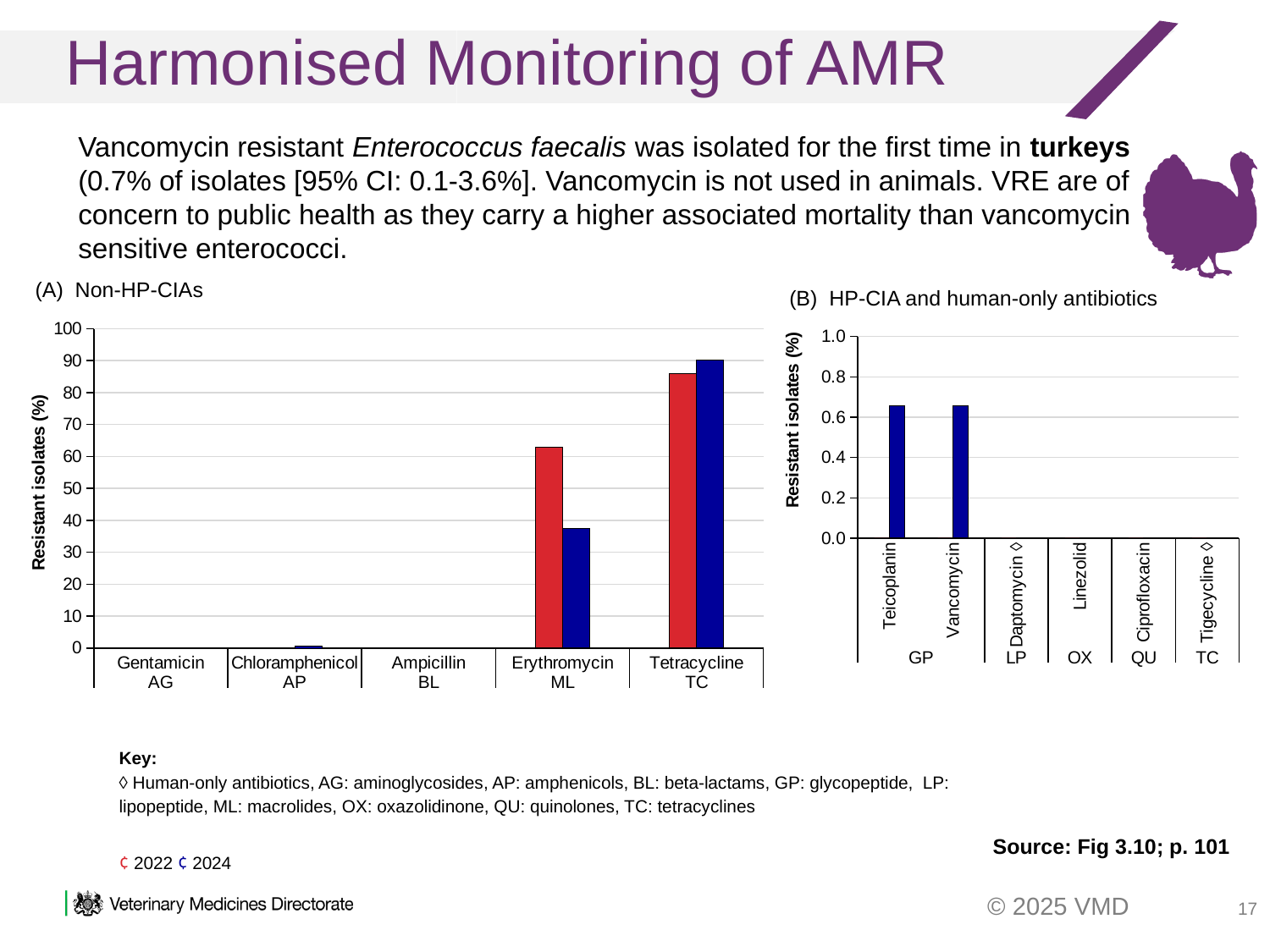
Which two years does the legend below the charts list? 2022 and 2024 What is the y-axis label of chart (B) HP-CIA and human-only antibiotics? Resistant isolates (%) In chart (A) Non-HP-CIAs, is the 2022 value for Erythromycin greater or less than 60? greater In chart (A) Non-HP-CIAs, which is larger, the 2024 value for Erythromycin or the 2024 value for Tetracycline? Tetracycline In chart (A) Non-HP-CIAs, is the 2024 value for Tetracycline greater or less than 80? greater In chart (B) HP-CIA and human-only antibiotics, is the value for Vancomycin greater or less than 0.6? greater How many antibiotic categories are shown on the x axis of chart (A) Non-HP-CIAs? 5 In chart (A) Non-HP-CIAs, which antibiotic has the highest resistance for 2024? Tetracycline How many antibiotic categories are shown on the x axis of chart (B) HP-CIA and human-only antibiotics? 6 What type of chart is chart (A) Non-HP-CIAs? bar chart In chart (A) Non-HP-CIAs, which is larger for Erythromycin, the 2022 value or the 2024 value? 2022